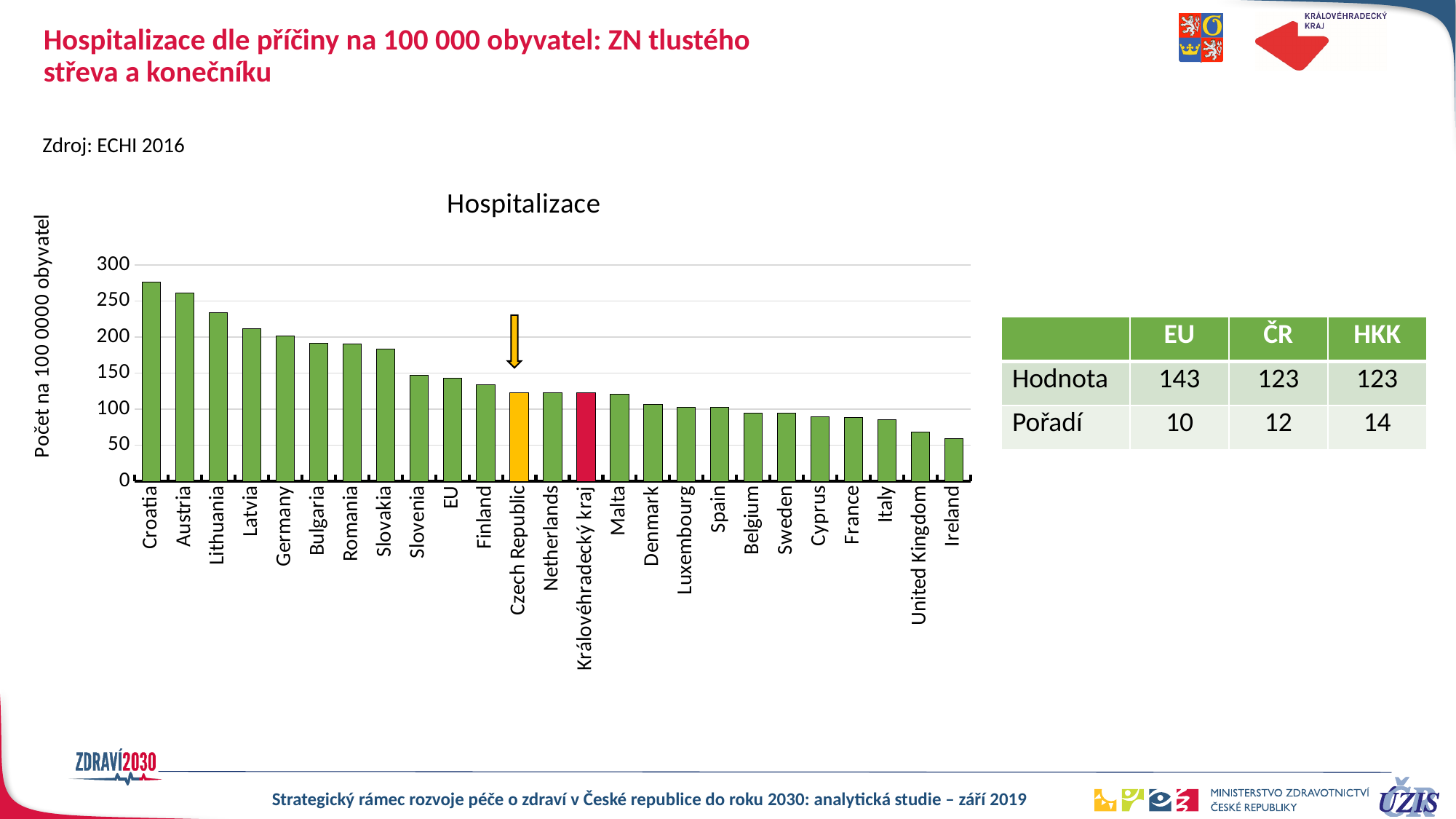
What is the value for EU? 143 Which category has the highest value in the chart? Croatia Which is larger, the value for Austria or the value for Lithuania? Austria Which category has the lowest value in the chart? Ireland What is the value for Czech Republic? 123 Is the value for Cyprus greater or less than 100? less How many bars (categories) are plotted in the chart? 25 What is the difference between the value for EU and the value for Czech Republic? 20 What type of chart is shown on the slide? bar chart Do the values rise or fall from left to right along the x axis? fall What is the title of the chart? Hospitalizace Is the value for Croatia greater or less than 250? greater